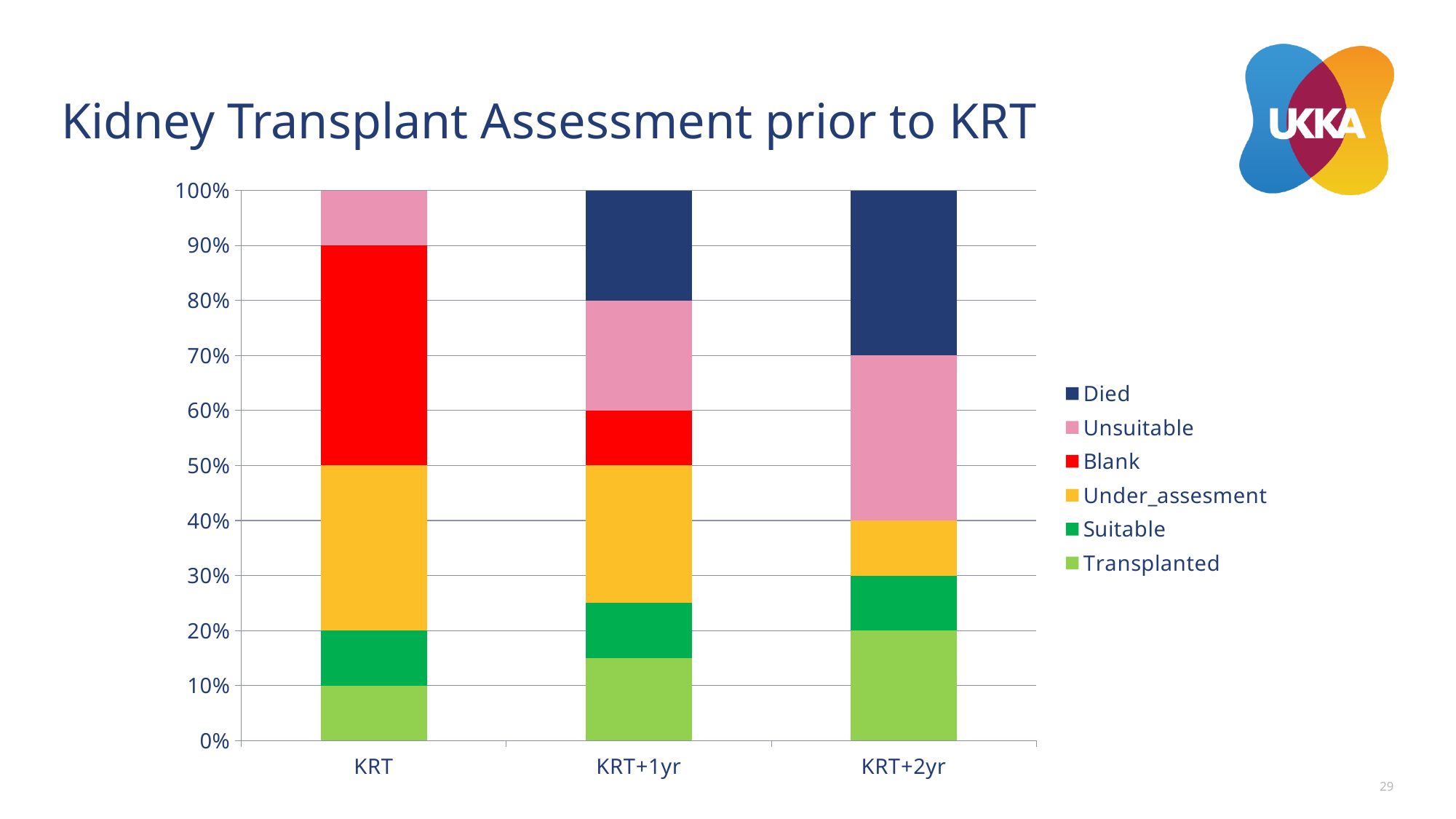
What is the title of the chart? Kidney Transplant Assessment prior to KRT Does the Transplanted share rise or fall from KRT to KRT+2yr? rise Is the Died share for KRT+2yr larger or smaller than the Died share for KRT+1yr? larger What is the Transplanted share for KRT+2yr? 20% What type of chart is shown on the slide? Stacked bar chart How many categories are shown on the x axis? 3 Which category has the largest Blank share? KRT How many series does the legend list? 6 What is the Transplanted share for KRT? 10% Which category has the largest Transplanted share? KRT+2yr Is the Unsuitable share for KRT+1yr greater or less than 30%? less Is the Blank share for KRT greater or less than 30%? greater